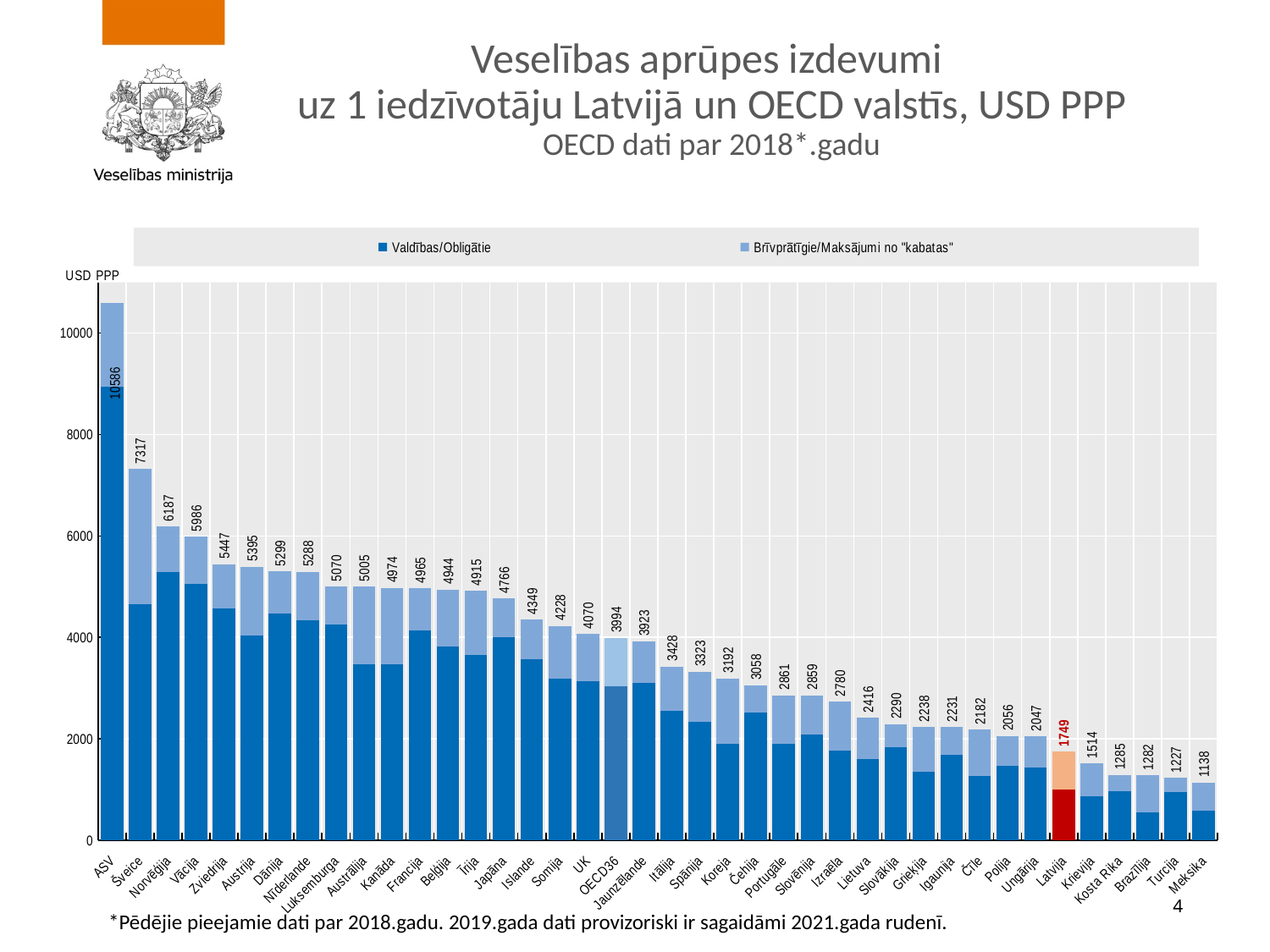
Which has a larger total value, Lietuva or Igaunija? Lietuva Which country has the highest total value in the chart? ASV Do the total values rise or fall moving from left to right along the x axis? Fall What is the value shown for OECD36? 3994 Is the total value for Norvēģija greater or less than 6000? greater What is the difference between the OECD36 value and the Latvija value? 2245 What is the total health expenditure per capita shown for Latvija? 1749 What is the value shown for Šveice? 7317 How many series does the legend list? 2 What kind of chart is shown on the slide? Stacked bar chart Which country has the lowest total value in the chart? Meksika How many countries/categories are shown on the x axis? 40